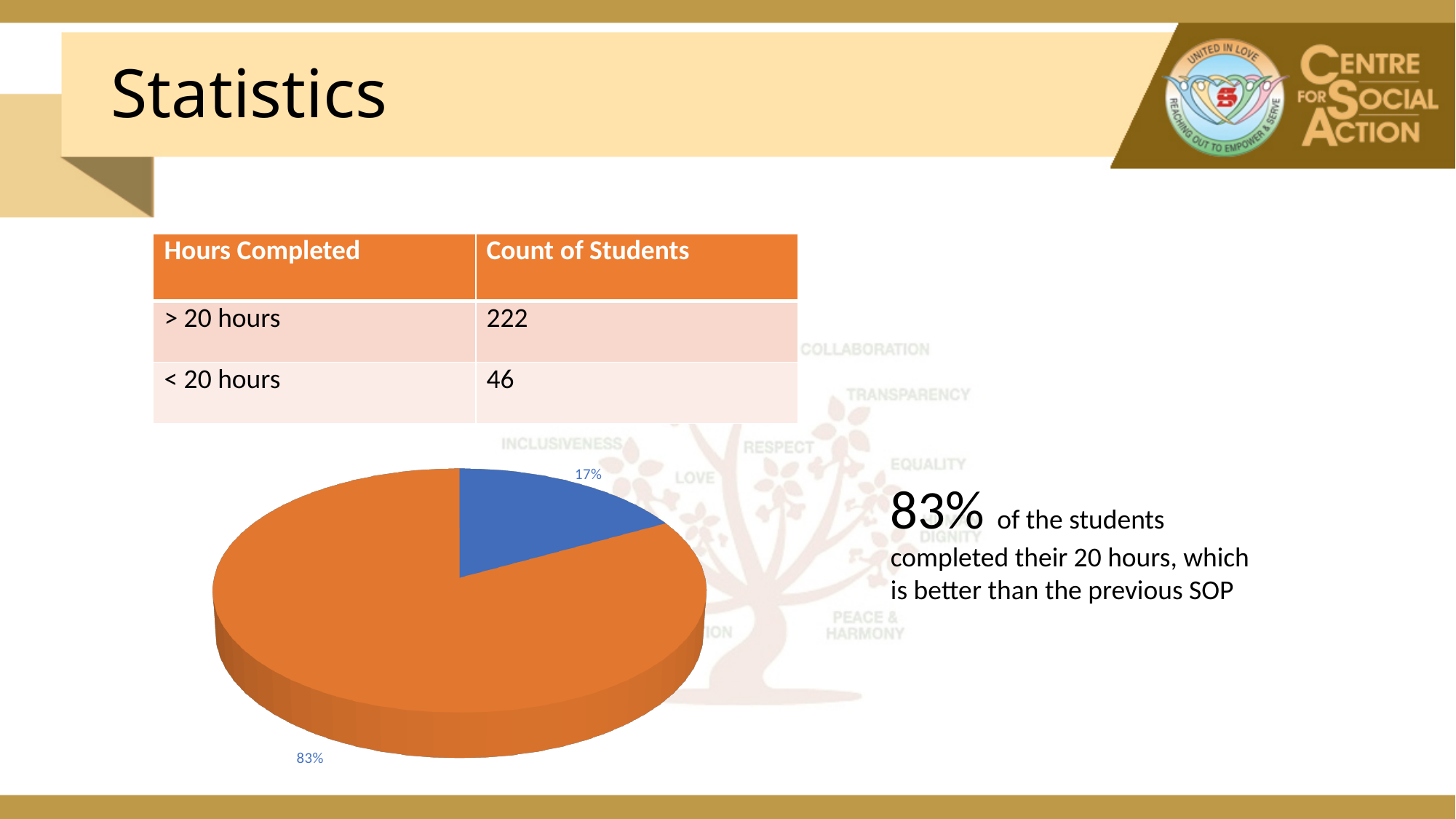
Is the share of the blue slice greater or less than 50%? less Does the pie chart display a legend? No Which slice of the pie chart is larger, the orange one or the blue one? orange Is the share of the orange slice greater or less than 50%? greater What percentage is shown for the blue slice of the pie chart? 17% What is the largest share shown on the pie chart? 83% What kind of chart is shown on the slide? pie chart What is the smallest share shown on the pie chart? 17% What is the difference in percentage points between the two slices of the pie chart? 66 How many slices does the pie chart have? 2 What colour is the slice labelled 17% in the pie chart? blue What percentage is shown for the orange slice of the pie chart? 83%